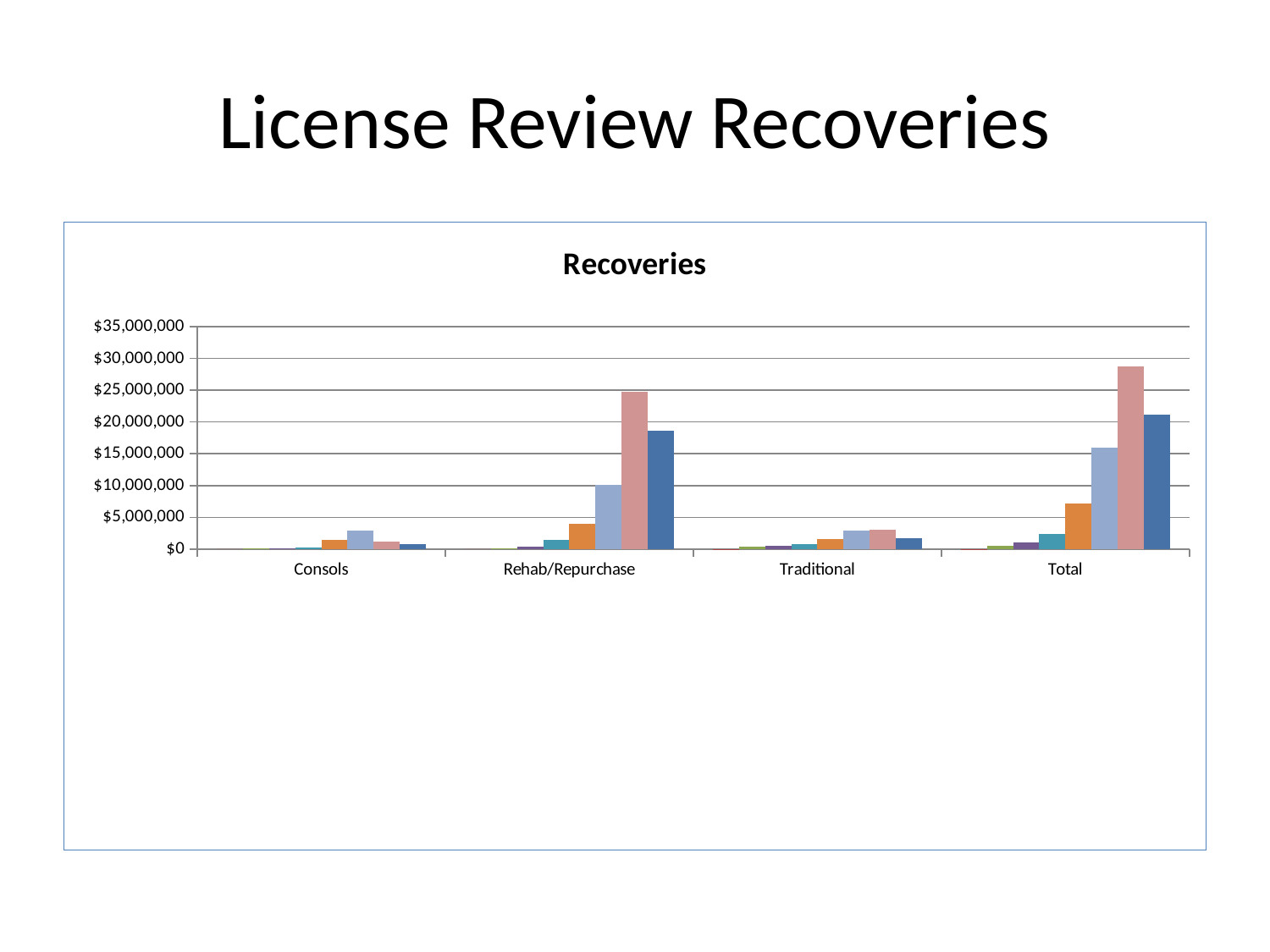
Is the value of the pink bar for Rehab/Repurchase greater or less than $20,000,000? greater Which category contains the tallest bar in the chart? Total Is the value of the dark blue bar for Rehab/Repurchase greater or less than $20,000,000? less Is the value of the orange bar for Consols greater or less than $5,000,000? less How many categories are shown on the x axis of the chart? 4 Which is larger, the pink bar for Total or the pink bar for Rehab/Repurchase? Total What is the title of the chart? Recoveries What kind of chart is shown on the slide? bar chart What is the highest value shown on the y axis of the chart? $35,000,000